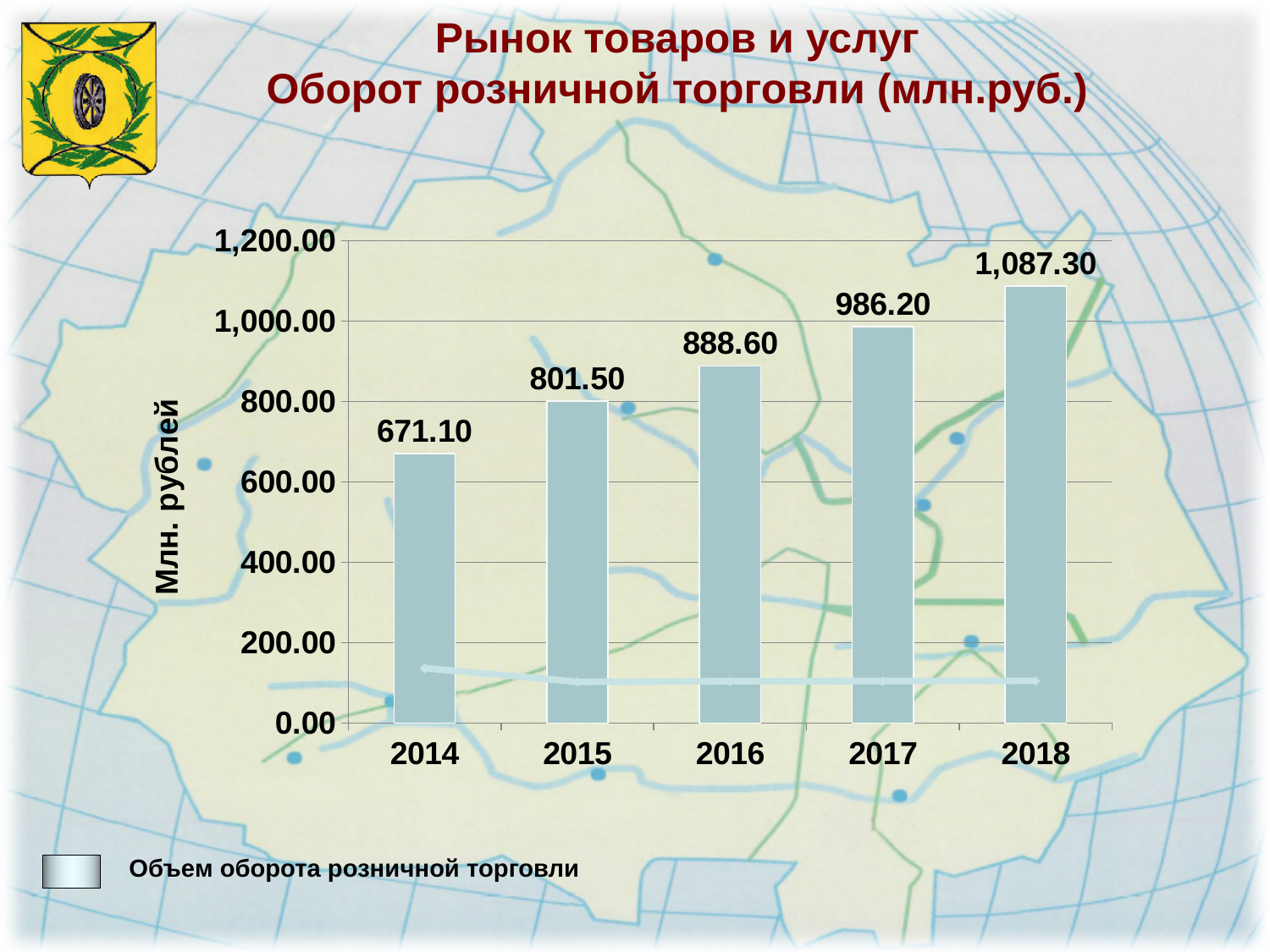
How many years are shown on the x axis? 5 Which year has the highest retail trade turnover? 2018 What is the value shown for 2018? 1,087.30 What kind of chart is shown on the slide? combination bar and line chart By how much did the value increase from 2017 to 2018? 101.10 Do the values rise or fall from 2014 to 2018? rise What value is labelled on the bar for 2014? 671.10 Which is larger, the value for 2016 or the value for 2017? 2017 Is the value for 2017 greater or less than 1,000.00? less What is the difference between the 2015 and 2014 values? 130.40 What is the retail trade turnover value shown for 2016? 888.60 Which year has the lowest retail trade turnover? 2014